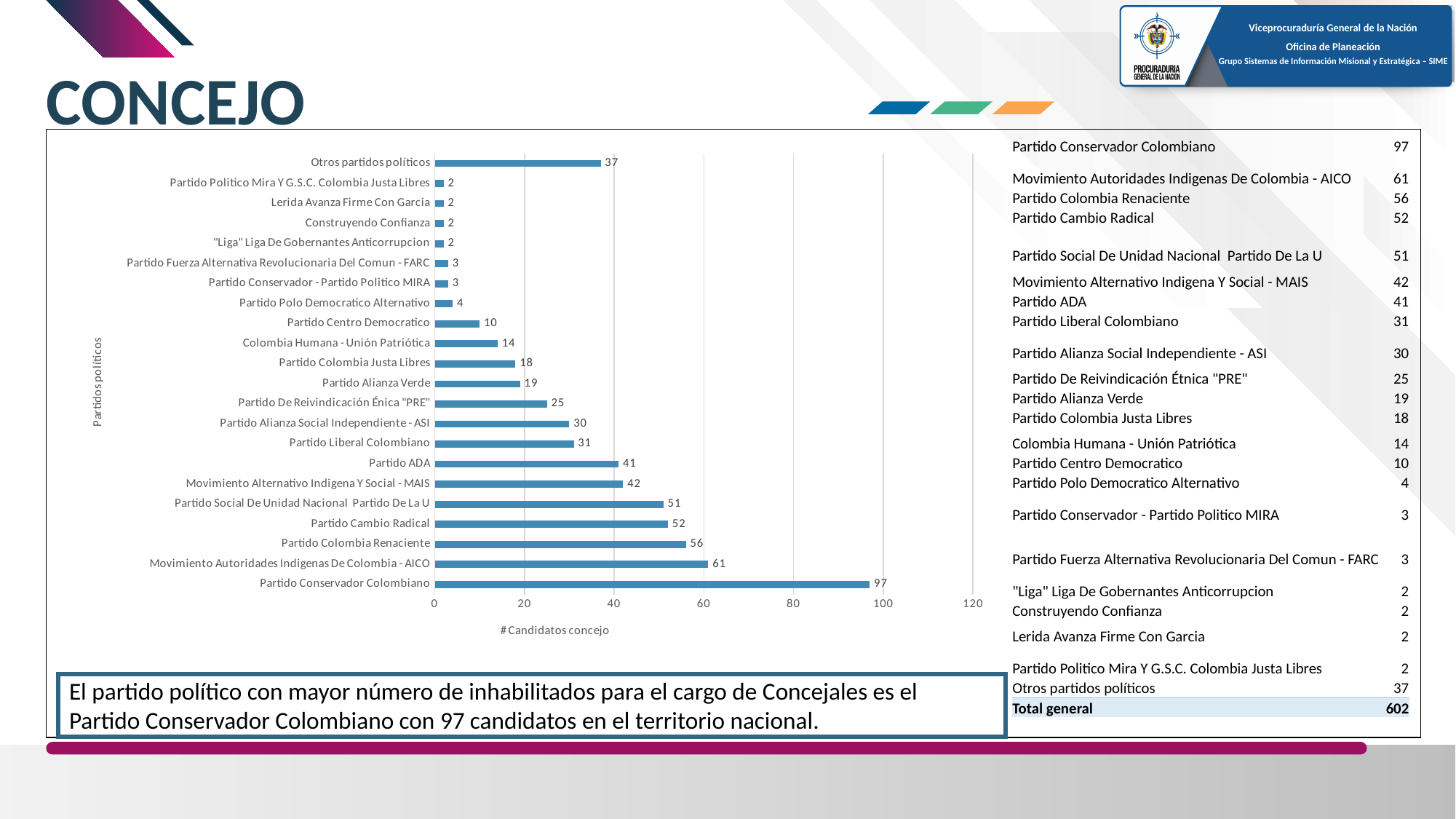
What is the title of the horizontal axis of the chart? # Candidatos concejo Which has a larger value, Partido ADA or Partido Liberal Colombiano? Partido ADA Is the value for Partido Social De Unidad Nacional Partido De La U greater or less than 40? greater What kind of chart is shown on the slide? bar chart How many candidates does the chart show for Partido Conservador Colombiano? 97 Which party has the highest number of candidates in the chart? Partido Conservador Colombiano What is the value for Partido Alianza Verde? 19 What is the difference between the values for Partido Cambio Radical and Partido Colombia Renaciente? 4 What is the difference between the values for Partido Conservador Colombiano and Movimiento Autoridades Indigenas De Colombia - AICO? 36 How many parties (categories) are plotted in the chart? 22 What is the value for Otros partidos políticos? 37 What is the value for Movimiento Autoridades Indigenas De Colombia - AICO? 61